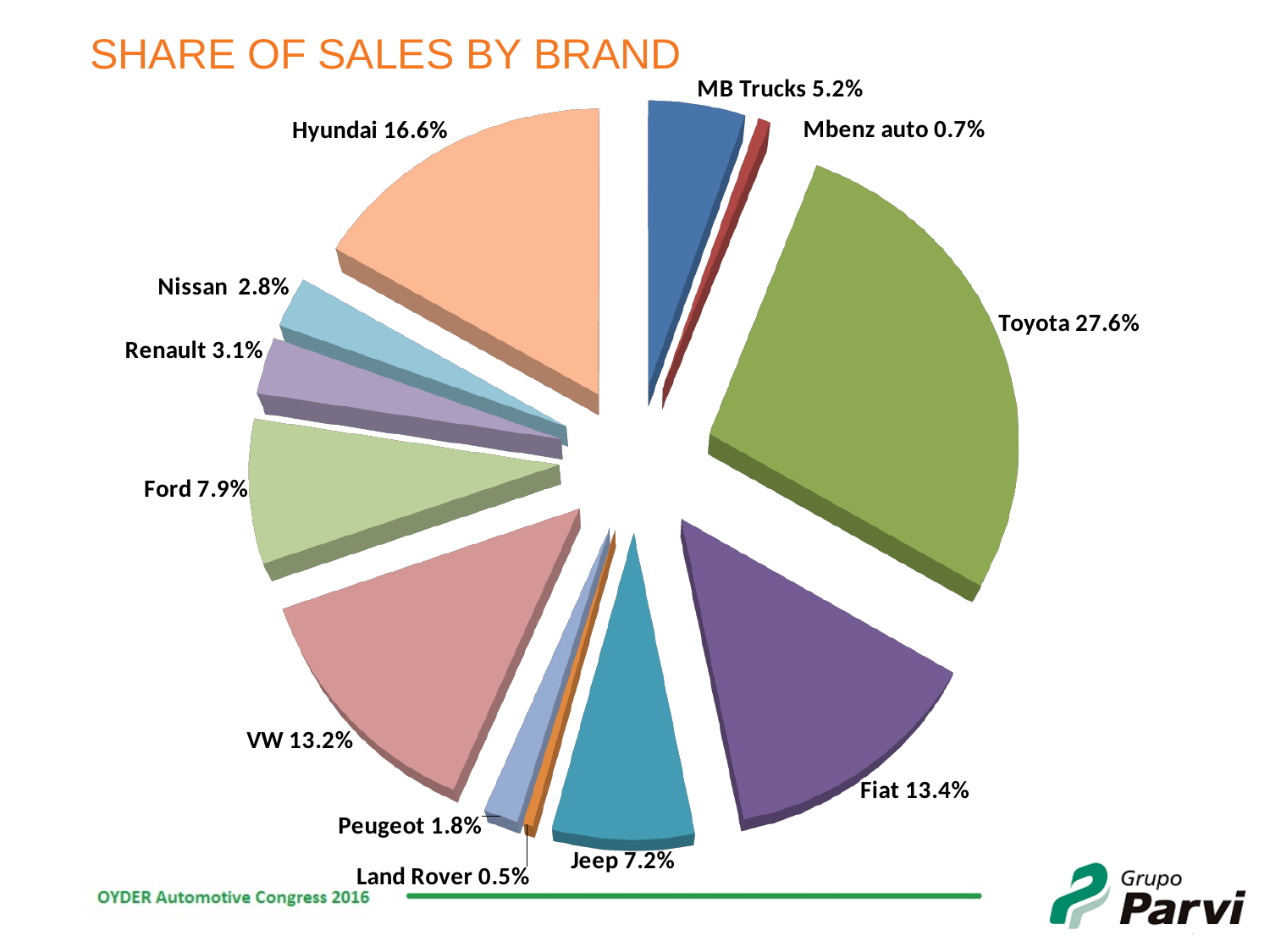
Which has a larger share of sales, Ford or Jeep? Ford What is the share of sales for Toyota? 27.6% Which has a larger share of sales, Renault or Nissan? Renault Which brand has the smallest share of sales? Land Rover How many brands are shown in the pie chart? 12 What is the difference between the shares of Fiat and VW? 0.2% Which brand has the largest share of sales? Toyota What is the difference between the shares of Toyota and Hyundai? 11.0% What is the title of the chart? SHARE OF SALES BY BRAND What is the share of sales for Hyundai? 16.6% What kind of chart is shown on the slide? Pie chart What is the share of sales for Land Rover? 0.5%